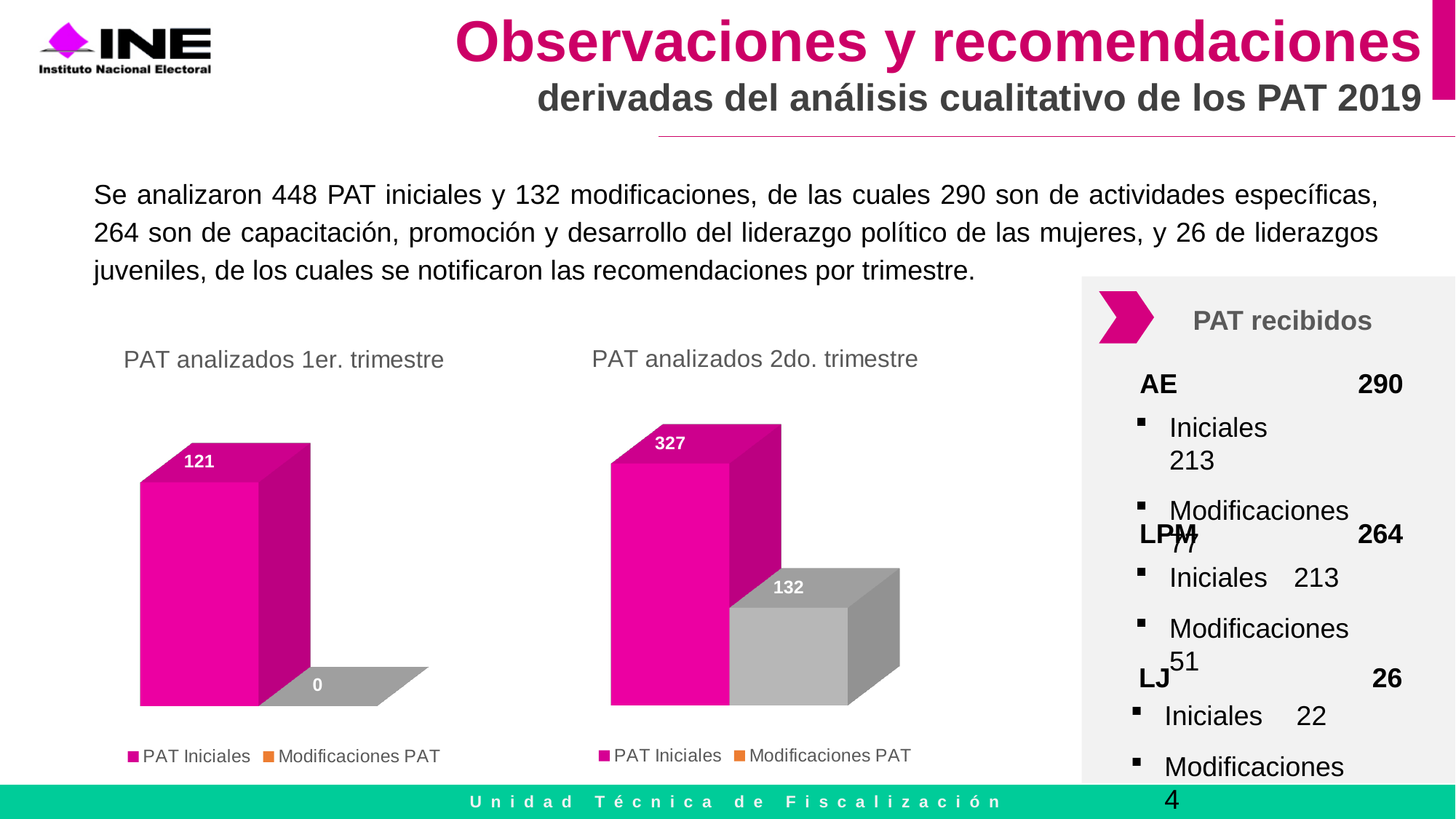
What is the title of the chart on the left side of the slide? PAT analizados 1er. trimestre In the chart 'PAT analizados 2do. trimestre', what is the value for PAT Iniciales? 327 In the chart 'PAT analizados 2do. trimestre', what is the value for Modificaciones PAT? 132 What is the difference between the PAT Iniciales value in the 2do. trimestre chart and the PAT Iniciales value in the 1er. trimestre chart? 206 In the chart 'PAT analizados 2do. trimestre', what is the difference between PAT Iniciales and Modificaciones PAT? 195 How many series does the legend of the chart 'PAT analizados 2do. trimestre' list? 2 In the chart 'PAT analizados 1er. trimestre', what is the value for Modificaciones PAT? 0 In the chart 'PAT analizados 1er. trimestre', which series has the lowest value? Modificaciones PAT In the chart 'PAT analizados 2do. trimestre', which series has the highest value? PAT Iniciales In the chart 'PAT analizados 1er. trimestre', what is the value for PAT Iniciales? 121 What kind of chart is 'PAT analizados 1er. trimestre'? Bar chart Which is larger: PAT Iniciales in the 1er. trimestre chart or Modificaciones PAT in the 2do. trimestre chart? Modificaciones PAT in the 2do. trimestre chart